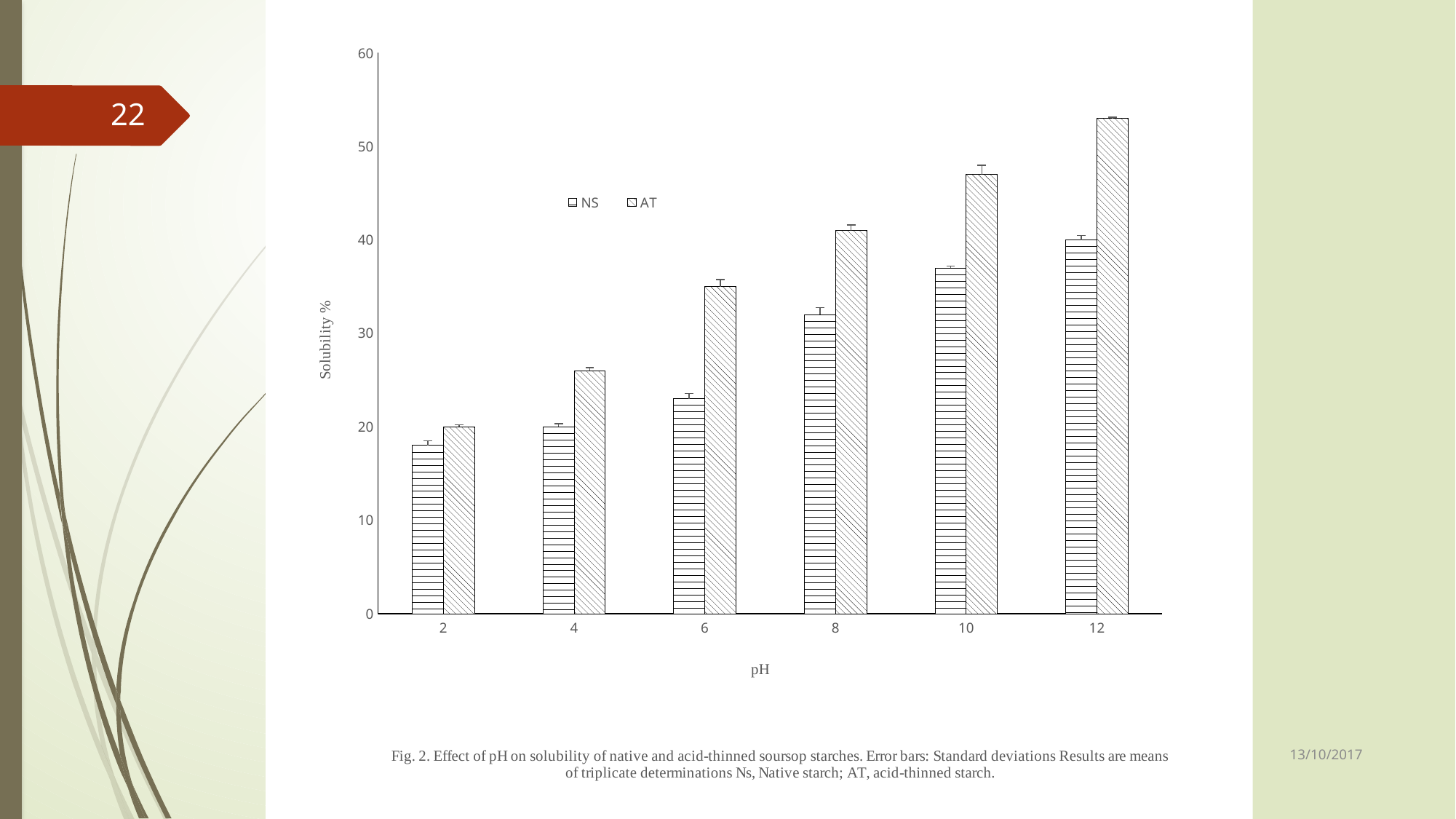
Is the NS value at pH 8 greater or less than 30? greater What kind of chart is shown on the slide? bar chart At which pH is the NS solubility lowest? 2 How many series does the legend list? 2 At which pH is the AT solubility highest? 12 What is the label of the y axis? Solubility % At pH 10, which series has the larger solubility, NS or AT? AT Is the AT value at pH 6 greater or less than 40? less Do the NS solubility values rise or fall as pH increases from 2 to 12? rise Is the AT value at pH 12 greater or less than 50? greater How many pH categories are plotted on the x axis? 6 What are the two series named in the legend? NS and AT